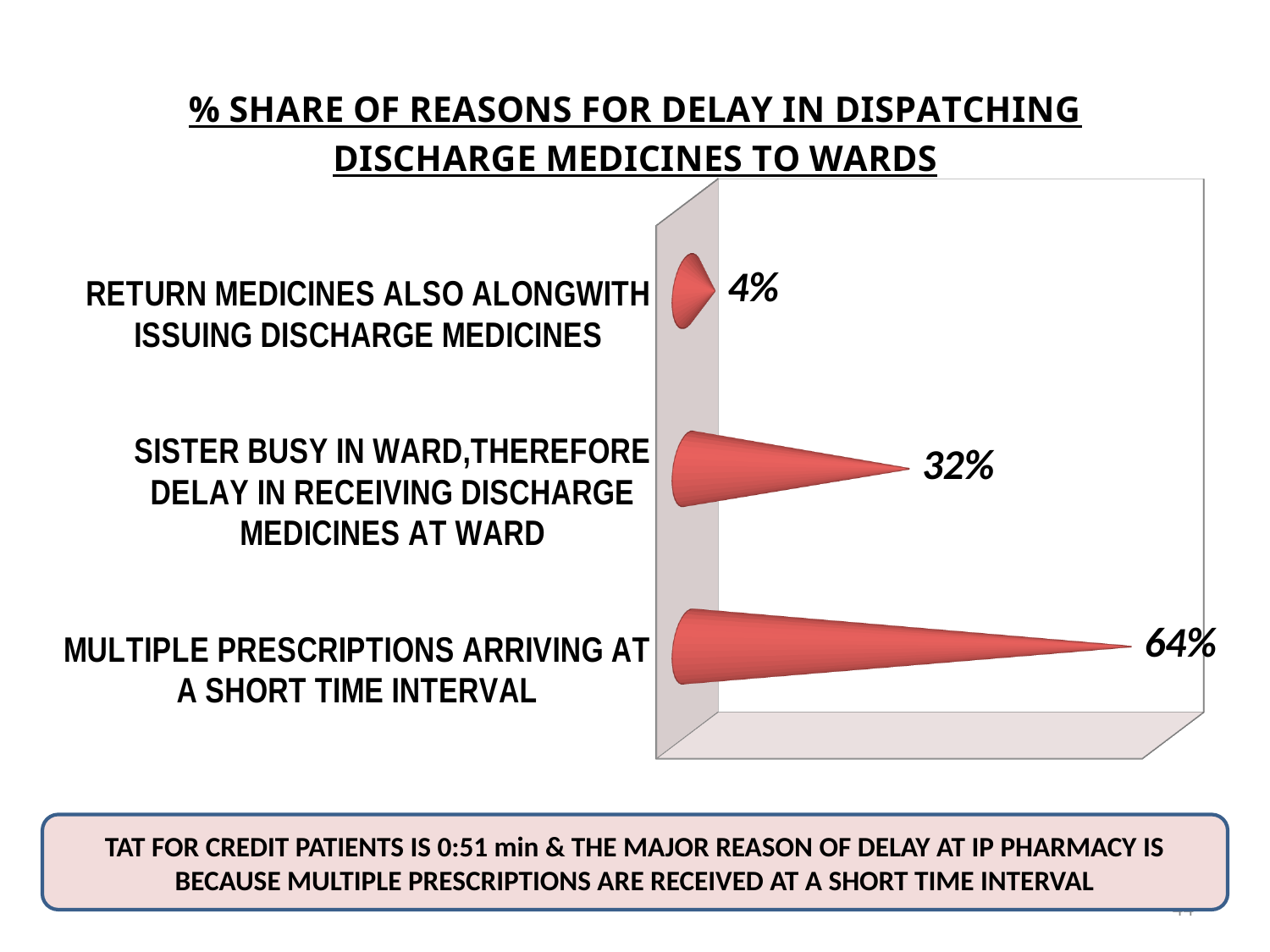
What colour are the bars in the chart? Red Which reason has the highest share? MULTIPLE PRESCRIPTIONS ARRIVING AT A SHORT TIME INTERVAL What is the difference between the share for MULTIPLE PRESCRIPTIONS ARRIVING AT A SHORT TIME INTERVAL and the share for SISTER BUSY IN WARD? 32% What is the difference between the share for SISTER BUSY IN WARD and the share for RETURN MEDICINES ALSO ALONGWITH ISSUING DISCHARGE MEDICINES? 28% What is the value for MULTIPLE PRESCRIPTIONS ARRIVING AT A SHORT TIME INTERVAL? 64% Which reason has the lowest share? RETURN MEDICINES ALSO ALONGWITH ISSUING DISCHARGE MEDICINES Which is larger: the share for SISTER BUSY IN WARD or the share for RETURN MEDICINES ALSO ALONGWITH ISSUING DISCHARGE MEDICINES? SISTER BUSY IN WARD What is the title of the chart? % SHARE OF REASONS FOR DELAY IN DISPATCHING DISCHARGE MEDICINES TO WARDS What kind of chart is shown on the slide? Bar chart What is the value for RETURN MEDICINES ALSO ALONGWITH ISSUING DISCHARGE MEDICINES? 4% How many reasons (categories) are shown in the chart? 3 What is the value for SISTER BUSY IN WARD, THEREFORE DELAY IN RECEIVING DISCHARGE MEDICINES AT WARD? 32%